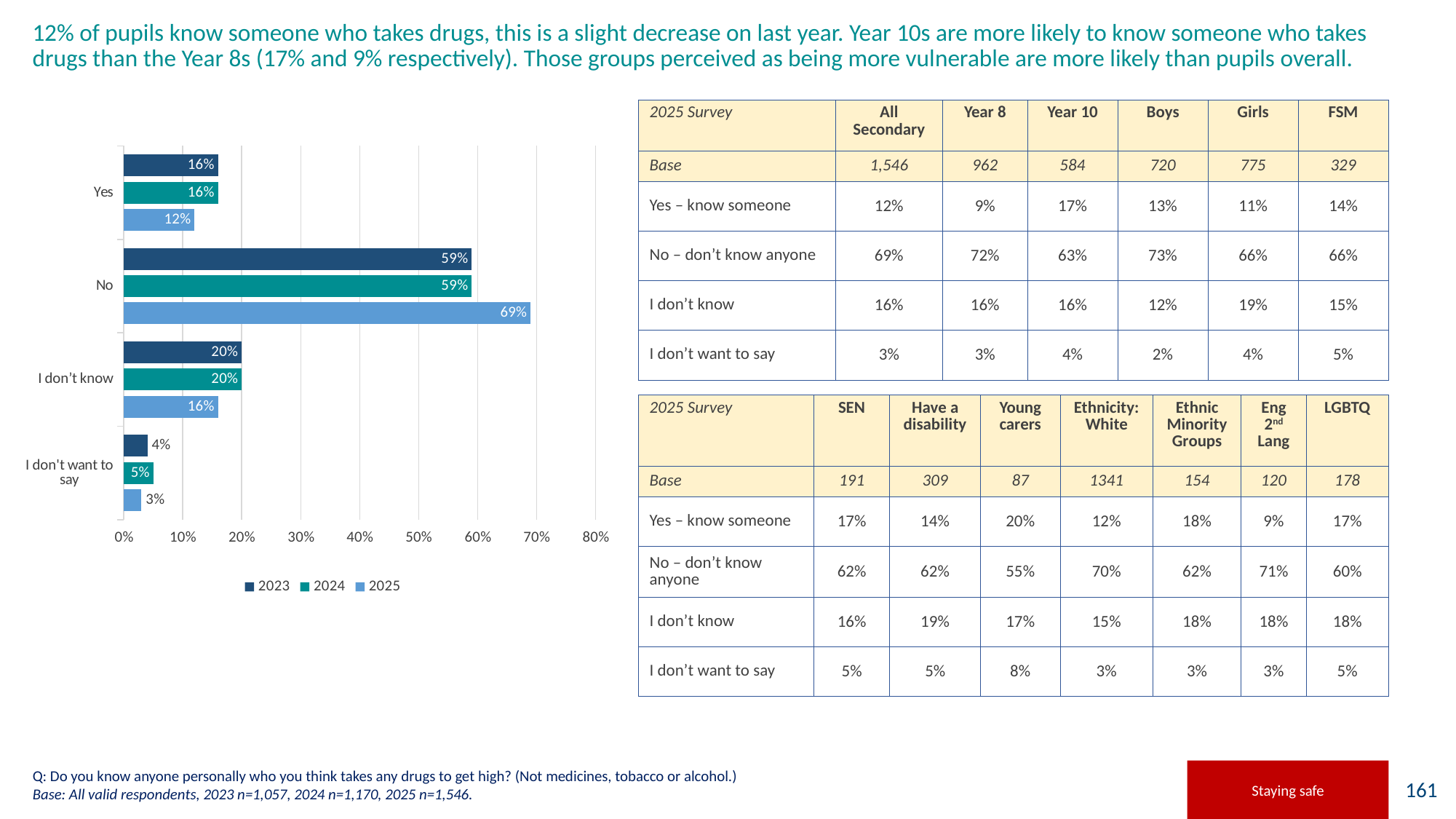
What is the 2024 value for 'I don't want to say' on the chart? 5% What is the 2023 value for 'I don't know' on the chart? 20% What is the 2025 value for 'No' on the chart? 69% Which response category has the highest value in 2025? No Is the 2025 value for 'Yes' larger or smaller than the 2024 value for 'Yes'? smaller Which response category has the lowest value in 2023? I don't want to say Is the 2025 value for 'No' greater or less than 60%? greater What kind of chart is shown on the slide? bar chart What is the difference between the 2025 and 2024 values for 'No'? 10% Which years are listed in the chart legend? 2023, 2024, 2025 How many response categories are shown on the chart? 4 How many series does the chart legend list? 3